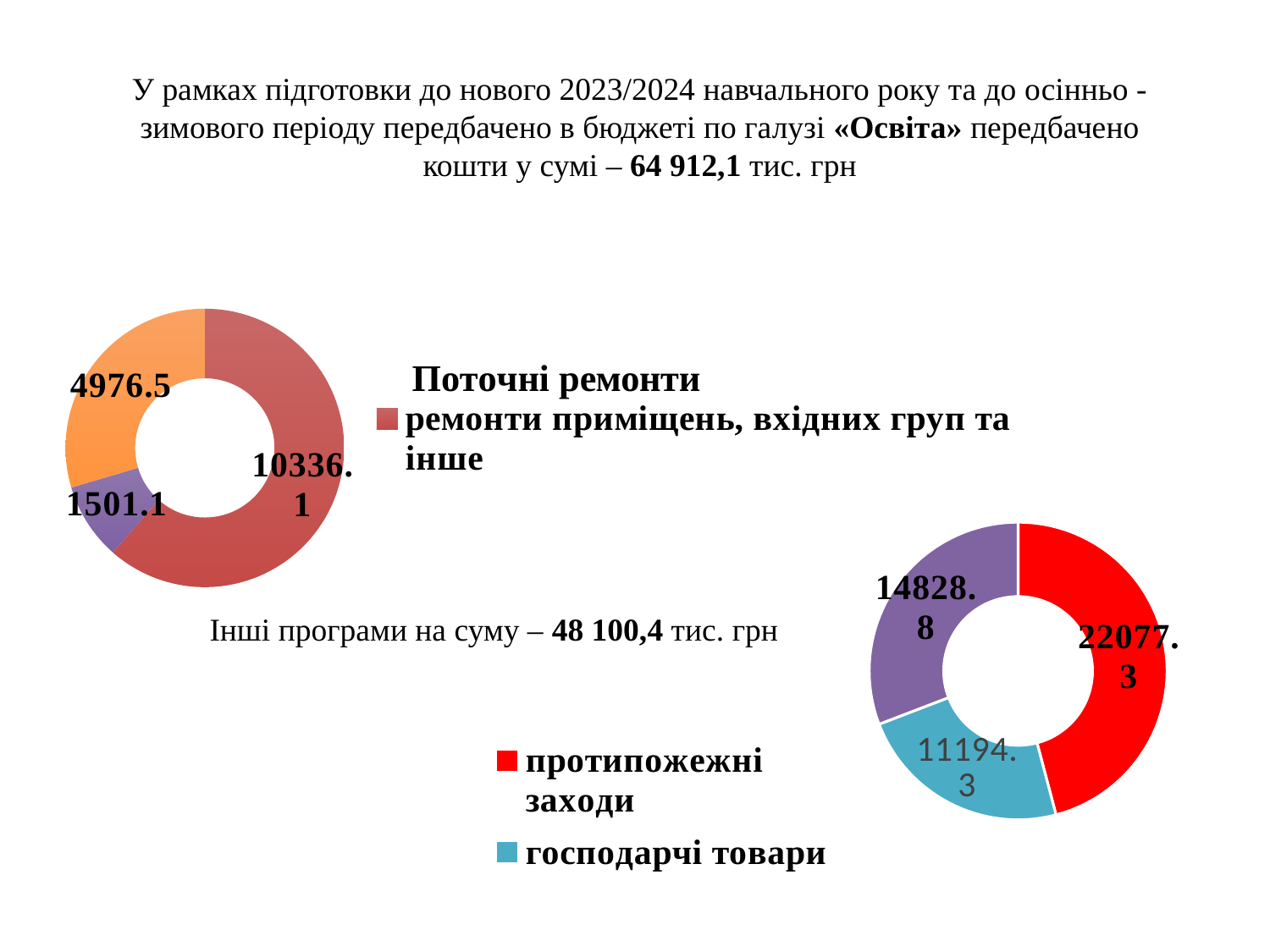
In the left doughnut chart (Поточні ремонти), what is the value for 'ремонти приміщень, вхідних груп та інше'? 10336.1 In the left doughnut chart (Поточні ремонти), what is the smallest value shown? 1501.1 In the right doughnut chart (Інші програми), which category has the smallest value? господарчі товари What type of chart is used on the right side of the slide (Інші програми)? Doughnut (pie) chart In the right doughnut chart (Інші програми), what is the value for 'господарчі товари'? 11194.3 How many slices does the left doughnut chart (Поточні ремонти) have? 3 In the left doughnut chart (Поточні ремонти), what is the difference between the largest value (10336.1) and the value 4976.5? 5359.6 In the right doughnut chart (Інші програми), what is the difference between 'протипожежні заходи' and 'господарчі товари'? 10883.0 In the right doughnut chart (Інші програми), what is the value for 'протипожежні заходи'? 22077.3 In the right doughnut chart (Інші програми), which is larger: 'протипожежні заходи' or 'господарчі товари'? протипожежні заходи How many entries does the legend of the right chart (Інші програми) list? 2 In the right doughnut chart (Інші програми), which category has the largest value? протипожежні заходи